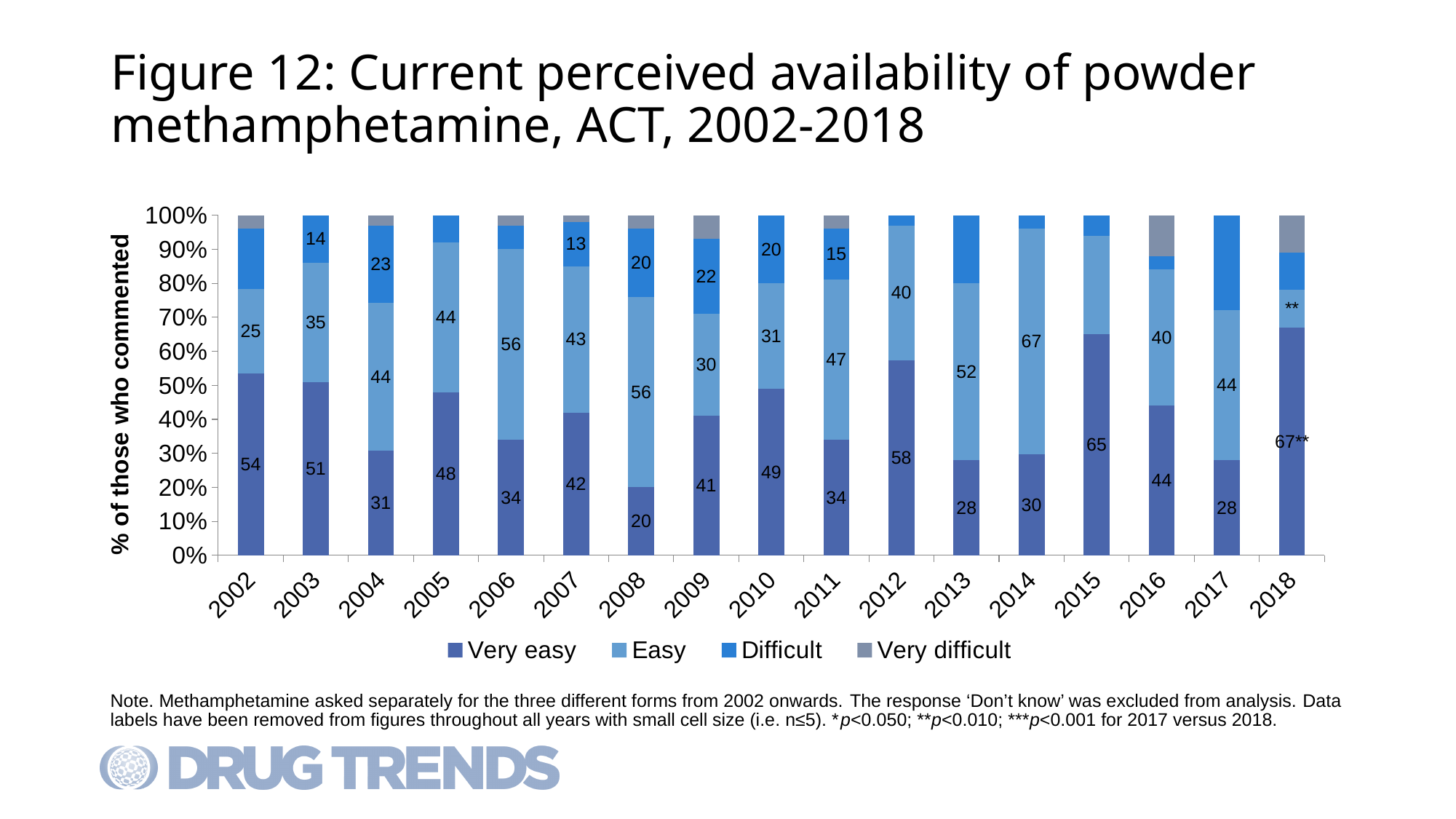
What is the 'Difficult' value for 2004? 23 What is the difference between the 'Very easy' values for 2015 and 2013? 37 How many series does the legend list? 4 What kind of chart is shown on the slide? Stacked bar chart How many years are shown along the x axis? 17 What is the 'Easy' value for 2014? 67 Which year has the larger 'Easy' value, 2006 or 2009? 2006 What is the 'Very easy' value for 2008? 20 Which year has the lowest 'Very easy' value? 2008 What is the label on the y axis? % of those who commented What is the 'Very easy' value for 2018? 67 Which year has the highest 'Very easy' value? 2018